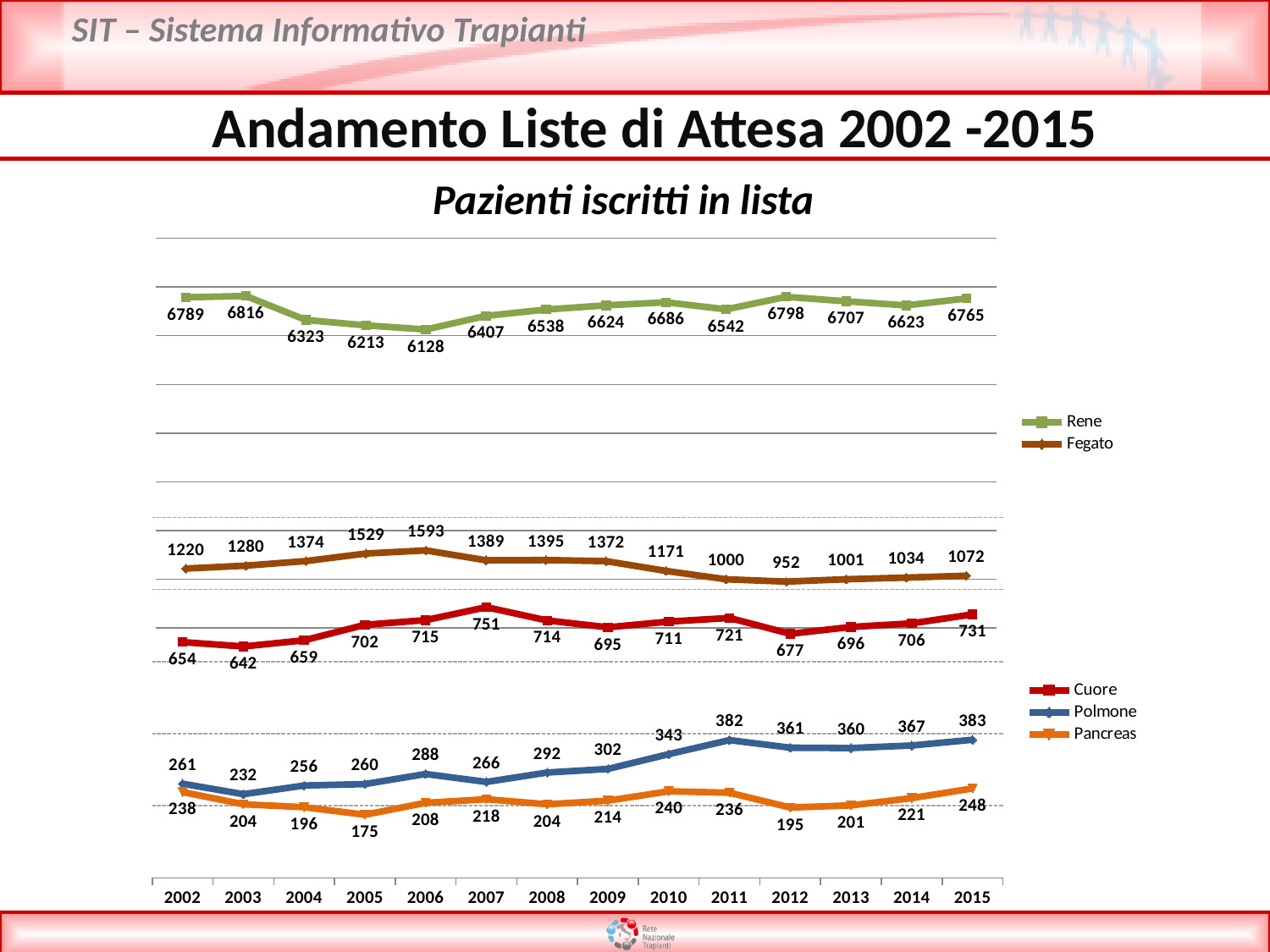
Which is larger in 2015, the Polmone value or the Pancreas value? Polmone What is the value for Pancreas in 2015? 248 In which year does the Pancreas series reach its lowest value? 2005 How many years are shown on the x axis? 14 Does the Fegato series rise or fall from 2006 to 2012? fall What is the value for Rene in 2006? 6128 In which year does the Fegato series reach its highest value? 2006 What is the difference between the Cuore value in 2015 and in 2002? 77 What kind of chart is shown on the slide? line chart How many series does the legend list? 5 In which year does the Cuore series reach its highest value? 2007 What is the value for Fegato in 2011? 1000